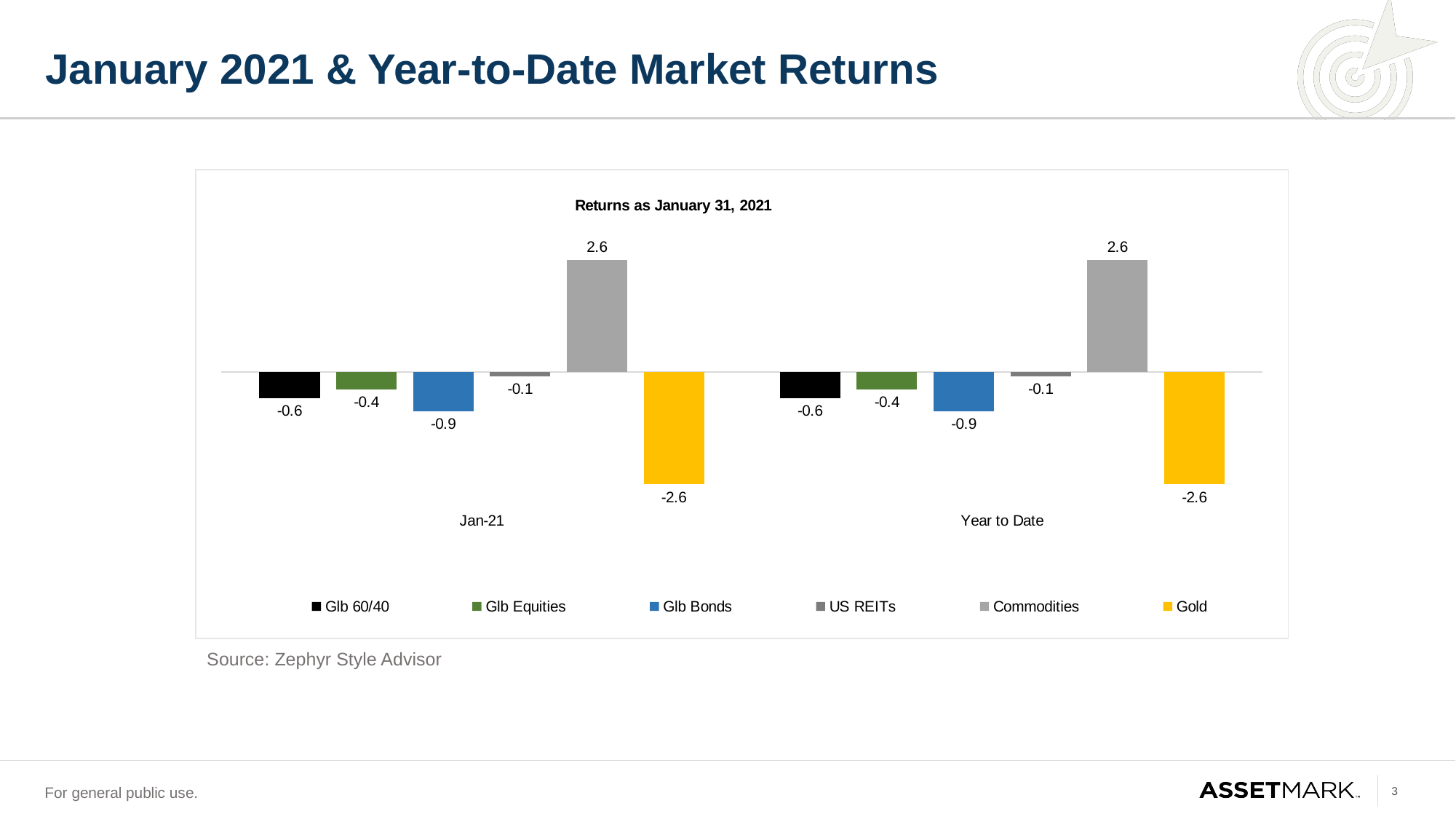
How many category groups are shown on the x axis? 2 What is the value for Commodities in the Jan-21 group? 2.6 What is the value for Gold in the Year to Date group? -2.6 How many series does the legend list? 6 Which series has the lowest value in the Year to Date group? Gold Which series has the highest value in the Jan-21 group? Commodities What is the value for US REITs in the Year to Date group? -0.1 Which is larger in the Jan-21 group, the value for Glb 60/40 or the value for Glb Equities? Glb Equities What is the value for Glb Bonds in the Jan-21 group? -0.9 What kind of chart is shown on the slide? Bar chart What is the difference between the Commodities and Gold values in the Jan-21 group? 5.2 What is the title of the chart? Returns as January 31, 2021